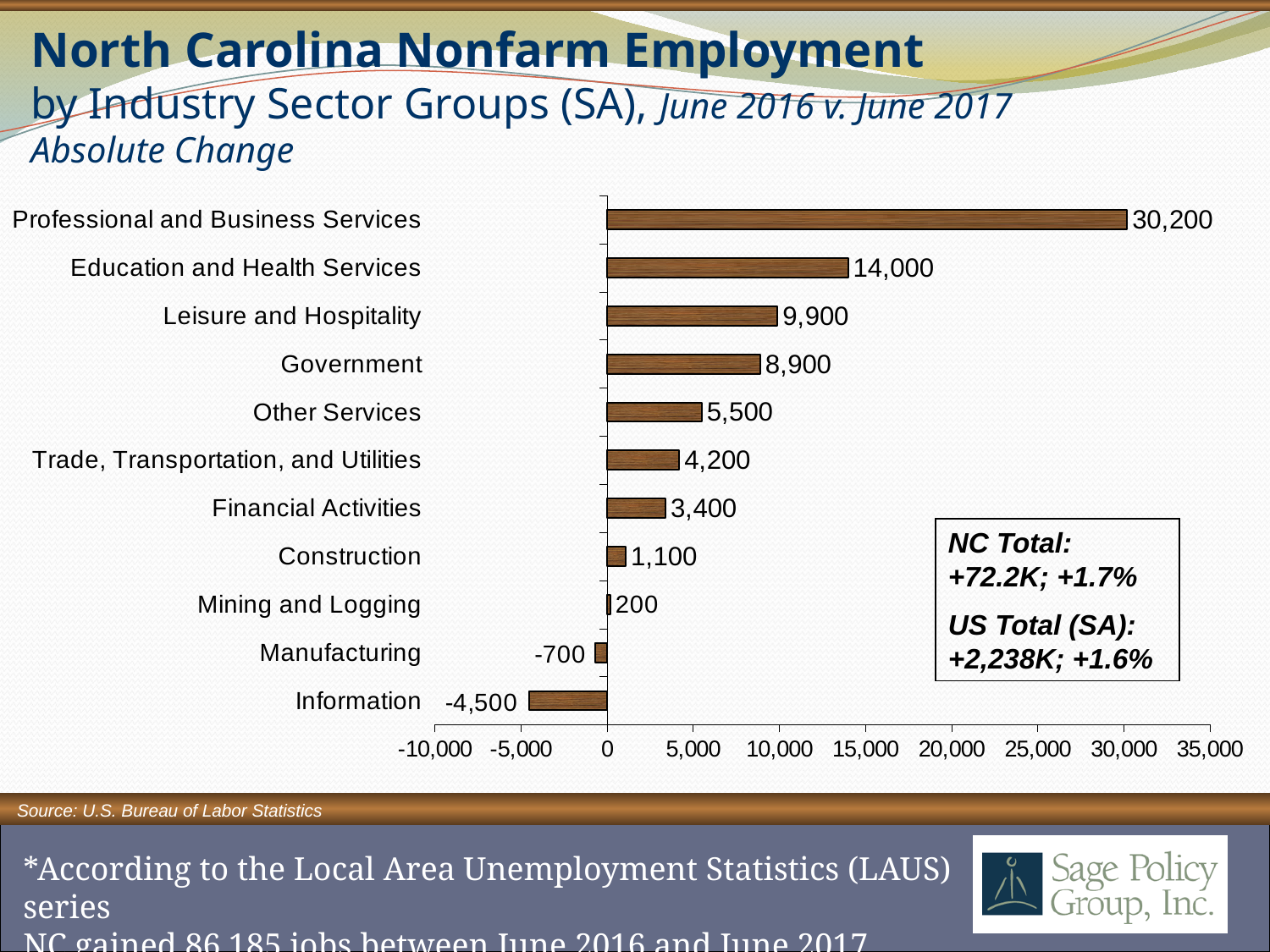
Which industry sector group has the lowest absolute change? Information How many industry sector groups are shown in the chart? 11 How many industry sector groups show a negative absolute change? 2 What is the absolute change in employment for Information? -4,500 Which has a larger absolute change, Other Services or Trade, Transportation, and Utilities? Other Services What is the difference between the absolute change for Education and Health Services and for Leisure and Hospitality? 4,100 What is the absolute change in employment for Professional and Business Services? 30,200 What kind of chart is shown on the slide? Bar chart What is the absolute change in employment for Manufacturing? -700 Which industry sector group has the largest absolute change? Professional and Business Services What is the NC Total change shown in the text box on the chart? +72.2K; +1.7% What is the absolute change in employment for Government? 8,900